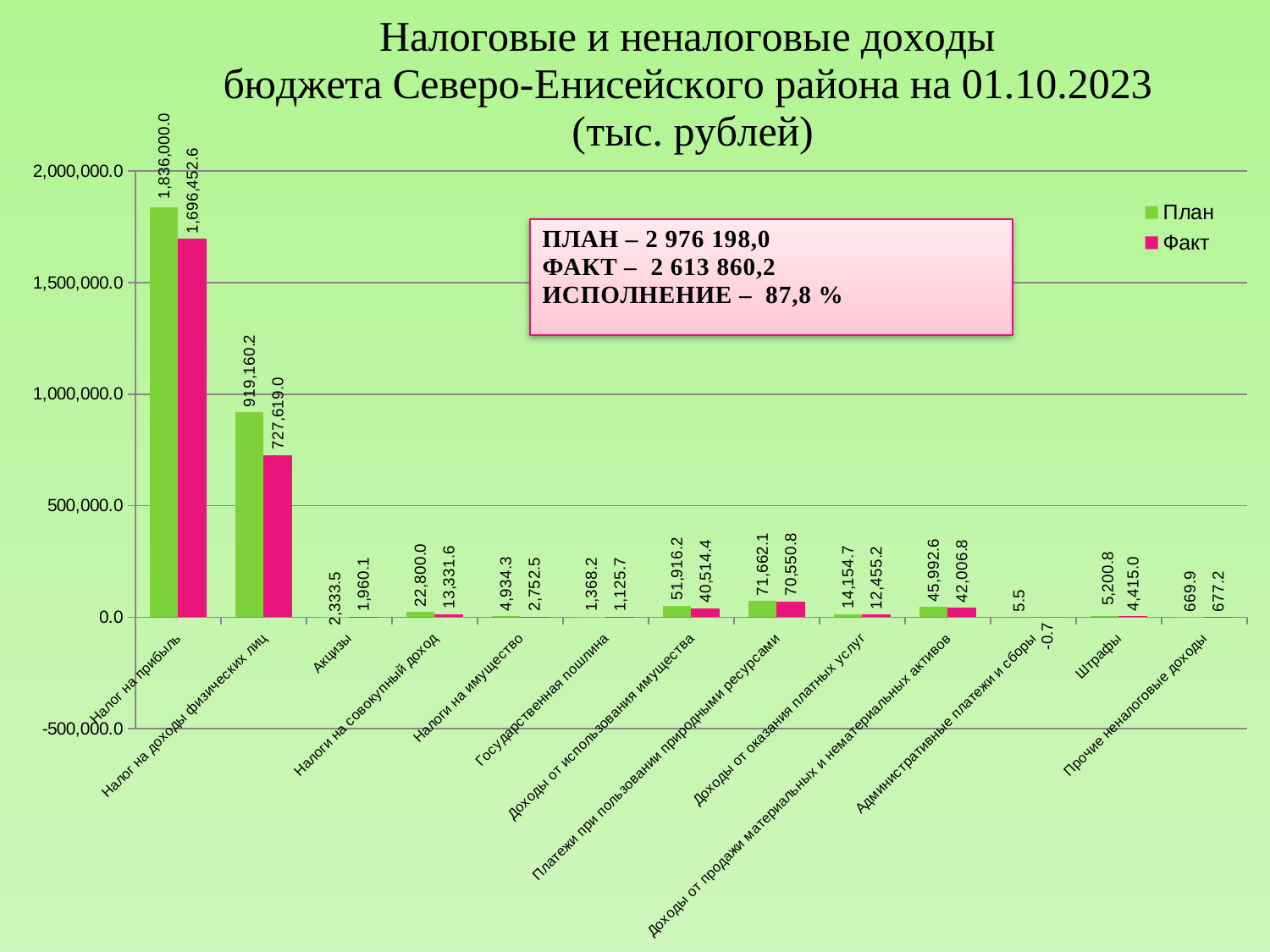
What is the difference between the План and Факт values for Налог на прибыль? 139,547.4 For Прочие неналоговые доходы, which is larger: План or Факт? Факт Which category has the lowest План value? Административные платежи и сборы Is the Факт value for Налог на доходы физических лиц greater or less than 500,000.0? greater What is the Факт value for Налог на доходы физических лиц? 727,619.0 How many series does the legend list? 2 How many categories are shown on the x axis? 13 What type of chart is shown on the slide? Bar chart What is the Факт value for Административные платежи и сборы? -0.7 What colour are the Факт bars? Pink Which category has the highest План value? Налог на прибыль What is the План value for Налог на прибыль? 1,836,000.0